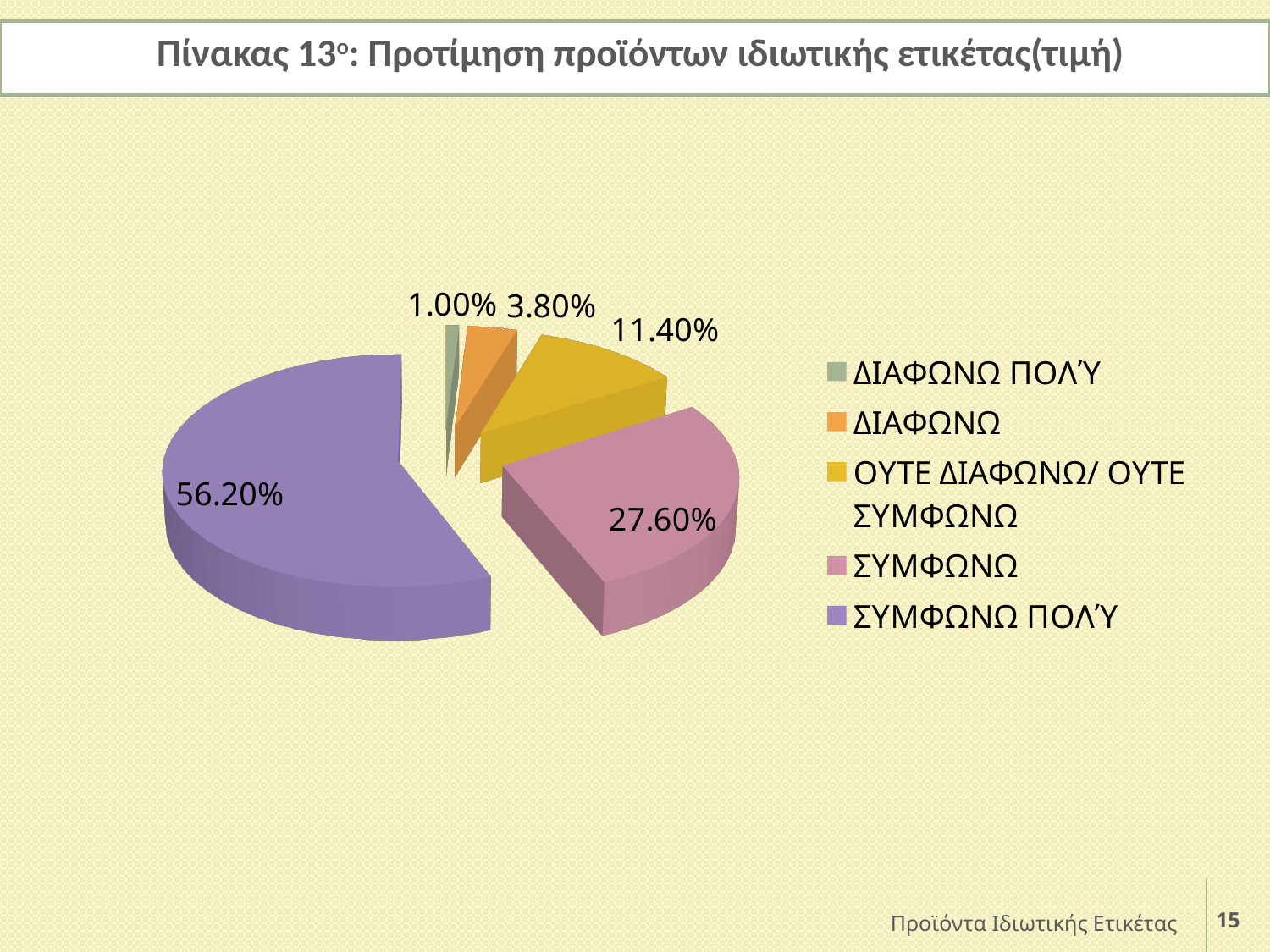
Which is larger, the value for ΟΥΤΕ ΔΙΑΦΩΝΩ/ ΟΥΤΕ ΣΥΜΦΩΝΩ or the value for ΔΙΑΦΩΝΩ? ΟΥΤΕ ΔΙΑΦΩΝΩ/ ΟΥΤΕ ΣΥΜΦΩΝΩ What is the value for ΔΙΑΦΩΝΩ? 3.80% What is the value for ΣΥΜΦΩΝΩ? 27.60% How many categories does the pie chart have? 5 Which category has the largest share of the pie? ΣΥΜΦΩΝΩ ΠΟΛΎ What colour is the slice for ΣΥΜΦΩΝΩ ΠΟΛΎ? Purple What is the value for ΟΥΤΕ ΔΙΑΦΩΝΩ/ ΟΥΤΕ ΣΥΜΦΩΝΩ? 11.40% What is the value for ΔΙΑΦΩΝΩ ΠΟΛΎ? 1.00% What kind of chart is shown on the slide? Pie chart What is the difference between the values for ΣΥΜΦΩΝΩ ΠΟΛΎ and ΣΥΜΦΩΝΩ? 28.60% What is the value for ΣΥΜΦΩΝΩ ΠΟΛΎ? 56.20% Which category has the smallest share of the pie? ΔΙΑΦΩΝΩ ΠΟΛΎ